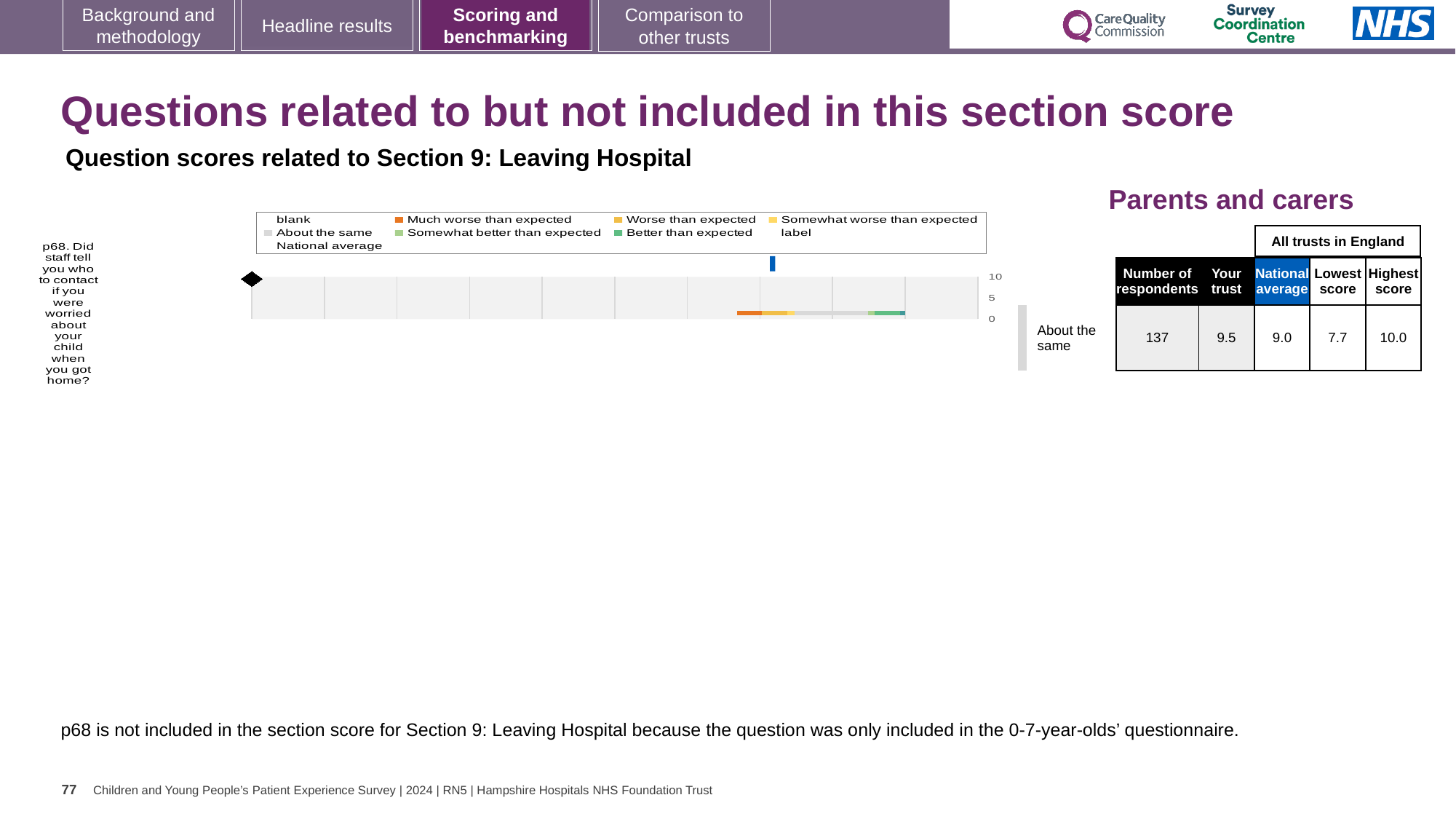
What is the lowest score among all trusts in England for p68? 7.7 What is the highest score among all trusts in England for p68? 10.0 What is the highest value shown on the chart's axis? 10 How many respondents answered p68? 137 What is the national average score for p68? 9.0 What is the difference between the highest score and the lowest score for p68? 2.3 Which is larger for p68, the 'Your trust' score or the national average? Your trust What kind of chart is shown for question p68? bar chart How many questions (categories) are plotted in the chart? 1 What is the 'Your trust' score for p68? 9.5 Which question is plotted in the chart? p68. Did staff tell you who to contact if you were worried about your child when you got home? What rating category is shown next to the chart for p68? About the same